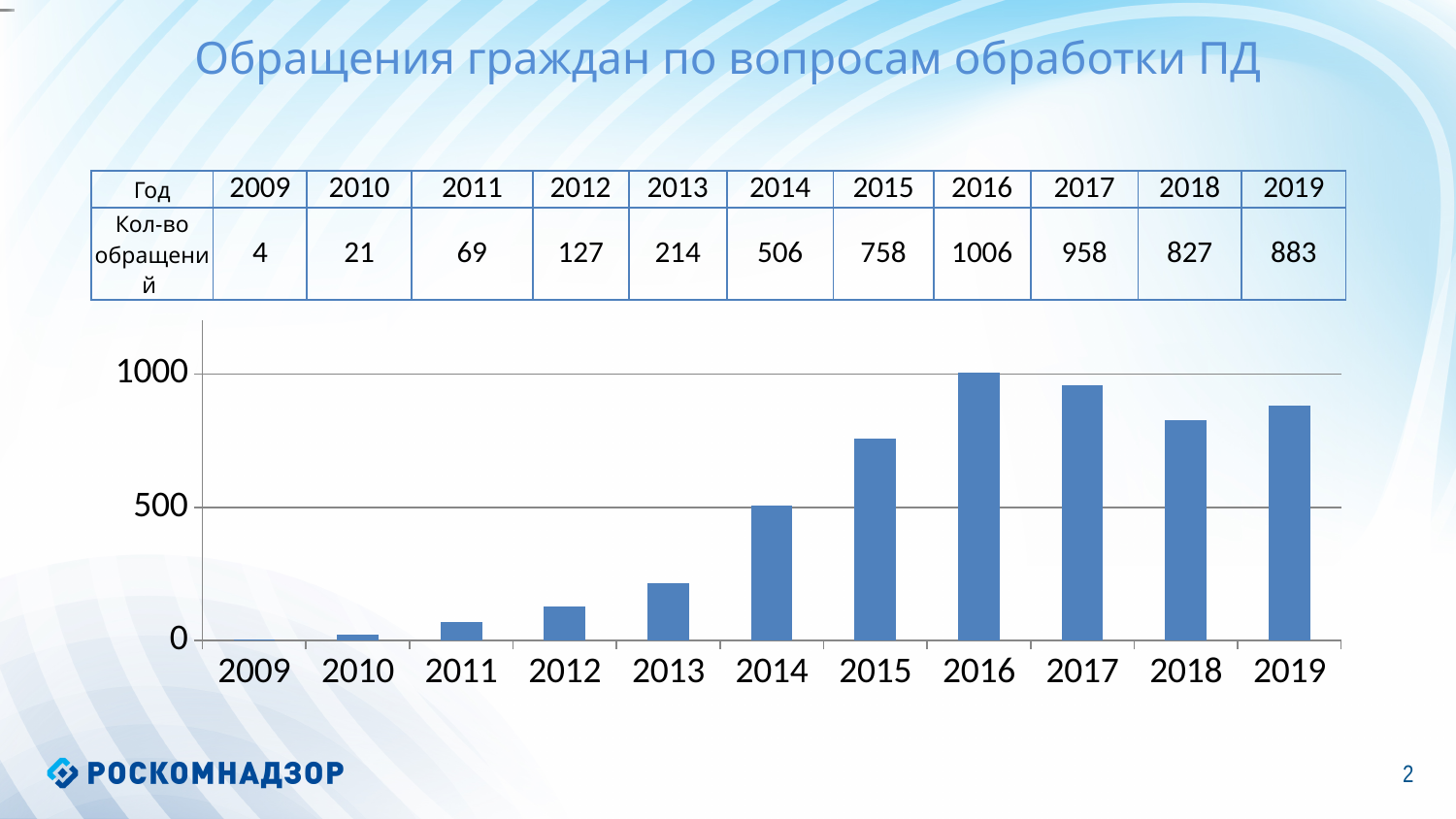
How many years are shown on the x axis of the chart? 11 Which year has the highest number of appeals? 2016 What is the difference between the number of appeals in 2019 and 2018? 56 Is the value for 2015 greater or less than 500? greater Which year has more appeals, 2018 or 2019? 2019 Do the values rise or fall from 2009 to 2016? rise What kind of chart is shown on the slide? bar chart What is the number of appeals for 2014? 506 By how much does the number of appeals in 2016 exceed that in 2017? 48 Which year has the lowest number of appeals? 2009 What is the number of appeals (Кол-во обращений) for 2016? 1006 What is the title of the slide? Обращения граждан по вопросам обработки ПД